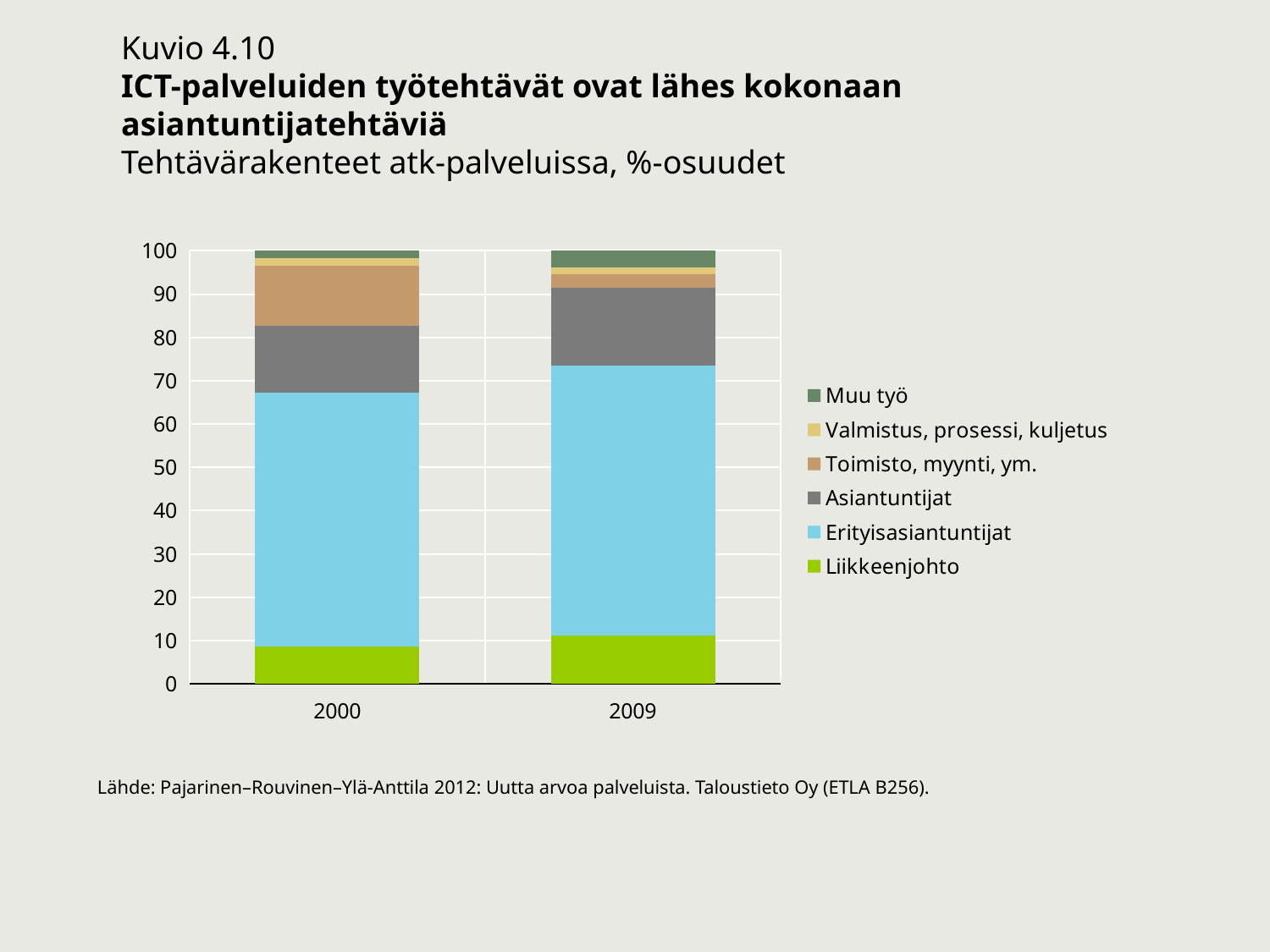
Is the Erityisasiantuntijat share in 2000 greater or less than 50? greater How many series does the legend list? 6 Is the Toimisto, myynti, ym. share in 2000 greater or less than 10? greater Which series forms the largest segment of the 2000 bar? Erityisasiantuntijat What is the total height of each stacked bar according to the y axis? 100 What kind of chart is shown on the slide? Stacked bar chart Which series forms the largest segment of the 2009 bar? Erityisasiantuntijat Which series forms the smallest segment of the 2009 bar? Valmistus, prosessi, kuljetus Is the Toimisto, myynti, ym. share larger in 2000 or in 2009? 2000 How many years (categories) are shown on the x axis? 2 Is the Toimisto, myynti, ym. share in 2009 greater or less than 10? less Which series is shown in light blue in the legend? Erityisasiantuntijat